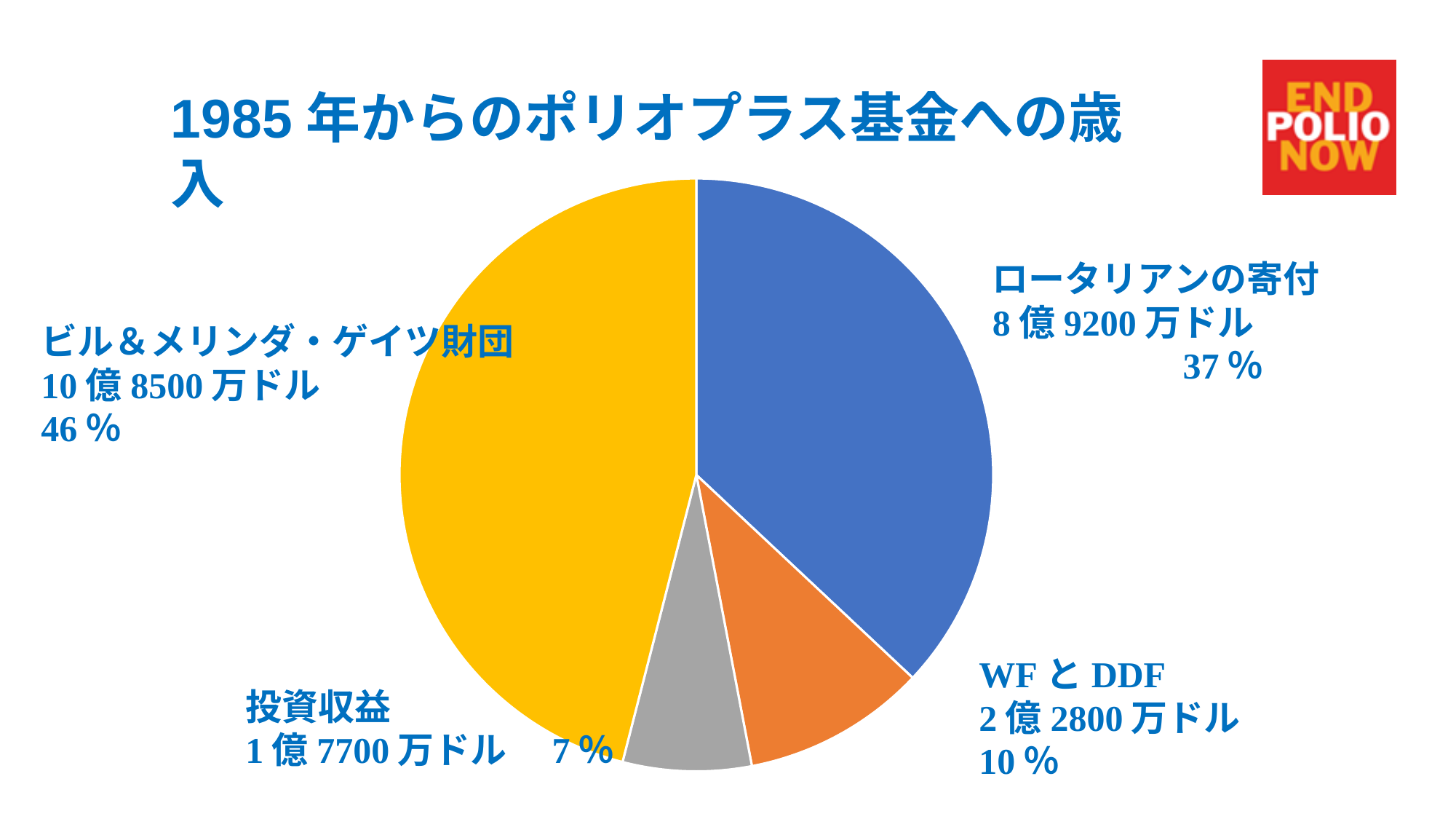
What is the amount shown for ロータリアンの寄付? 8 億 9200 万ドル What is the amount shown for WF と DDF? 2 億 2800 万ドル What is the amount shown for 投資収益? 1 億 7700 万ドル Which is larger, the share for ロータリアンの寄付 or the share for WF と DDF? ロータリアンの寄付 How many slices does the pie chart have? 4 By how many percentage points does the share of ビル＆メリンダ・ゲイツ財団 exceed the share of ロータリアンの寄付? 9 percentage points Which category has the smallest slice of the pie? 投資収益 What kind of chart is shown on the slide? Pie chart What share of the pie does ロータリアンの寄付 account for? 37 % What share of the pie does ビル＆メリンダ・ゲイツ財団 account for? 46 % Which category has the largest slice of the pie? ビル＆メリンダ・ゲイツ財団 What is the title of the chart on the slide? 1985 年からのポリオプラス基金への歳入